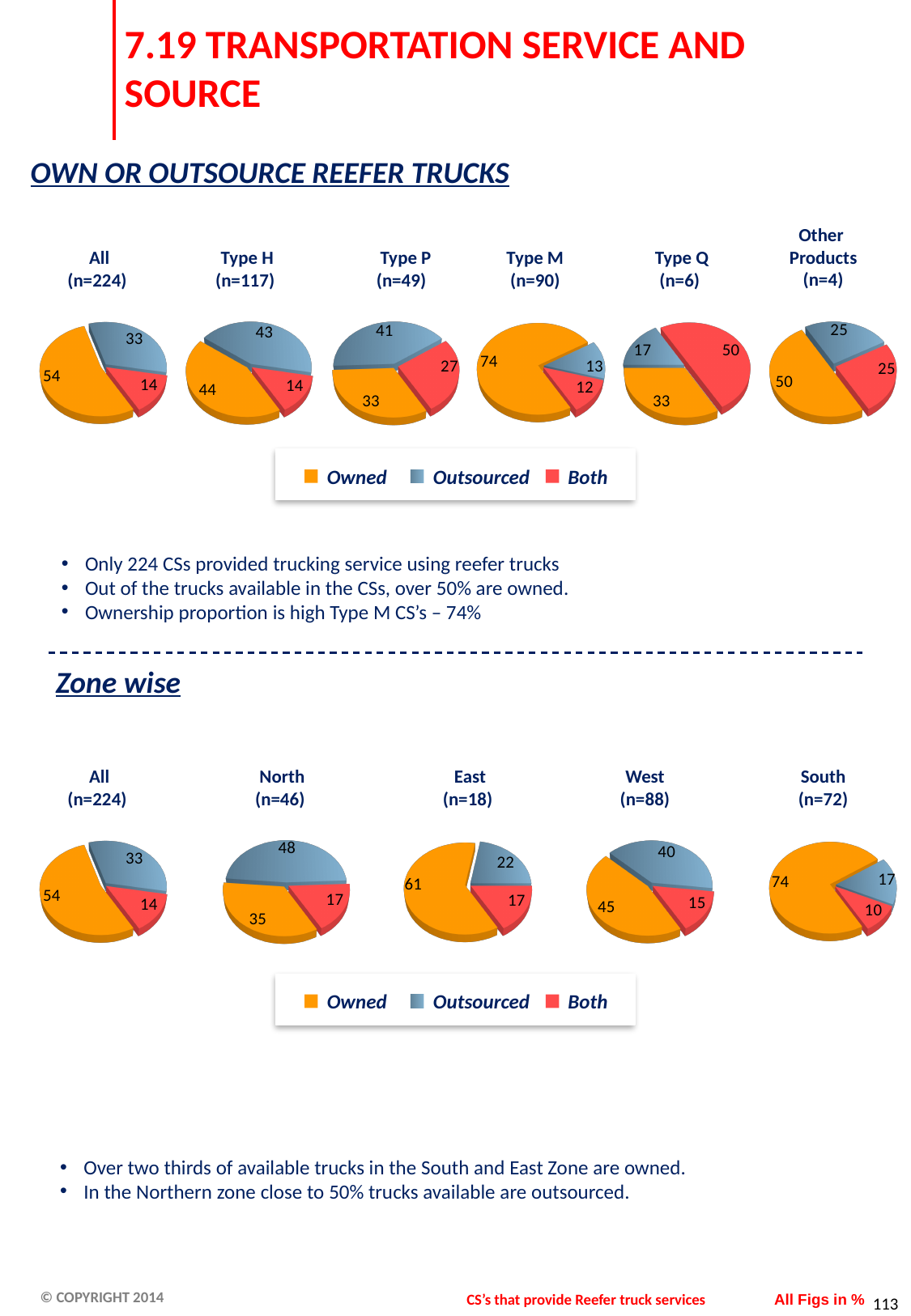
In the 'South (n=72)' pie chart in the 'Zone wise' section, which category has the smallest slice? Both In the 'East (n=18)' pie chart in the 'Zone wise' section, what is the difference between the Owned and Outsourced values? 39 What kind of chart is used for 'All (n=224)' in the 'Own or Outsource Reefer Trucks' section? Pie chart In the 'Type H (n=117)' pie chart in the 'Own or Outsource Reefer Trucks' section, which is larger, Owned or Outsourced? Owned In the 'Type M (n=90)' pie chart in the 'Own or Outsource Reefer Trucks' section, what is the value for Owned? 74 In the 'North (n=46)' pie chart in the 'Zone wise' section, what is the value for Outsourced? 48 In the 'Other Products (n=4)' pie chart in the 'Own or Outsource Reefer Trucks' section, what is the value for Owned? 50 In the 'Type P (n=49)' pie chart in the 'Own or Outsource Reefer Trucks' section, which category has the largest slice? Outsourced How many pie charts are shown in the 'Zone wise' section? 5 How many series does the legend below the 'Own or Outsource Reefer Trucks' charts list? 3 In the 'West (n=88)' pie chart in the 'Zone wise' section, what is the difference between the Owned and Both values? 30 In the 'Type Q (n=6)' pie chart in the 'Own or Outsource Reefer Trucks' section, what is the value for Both? 50